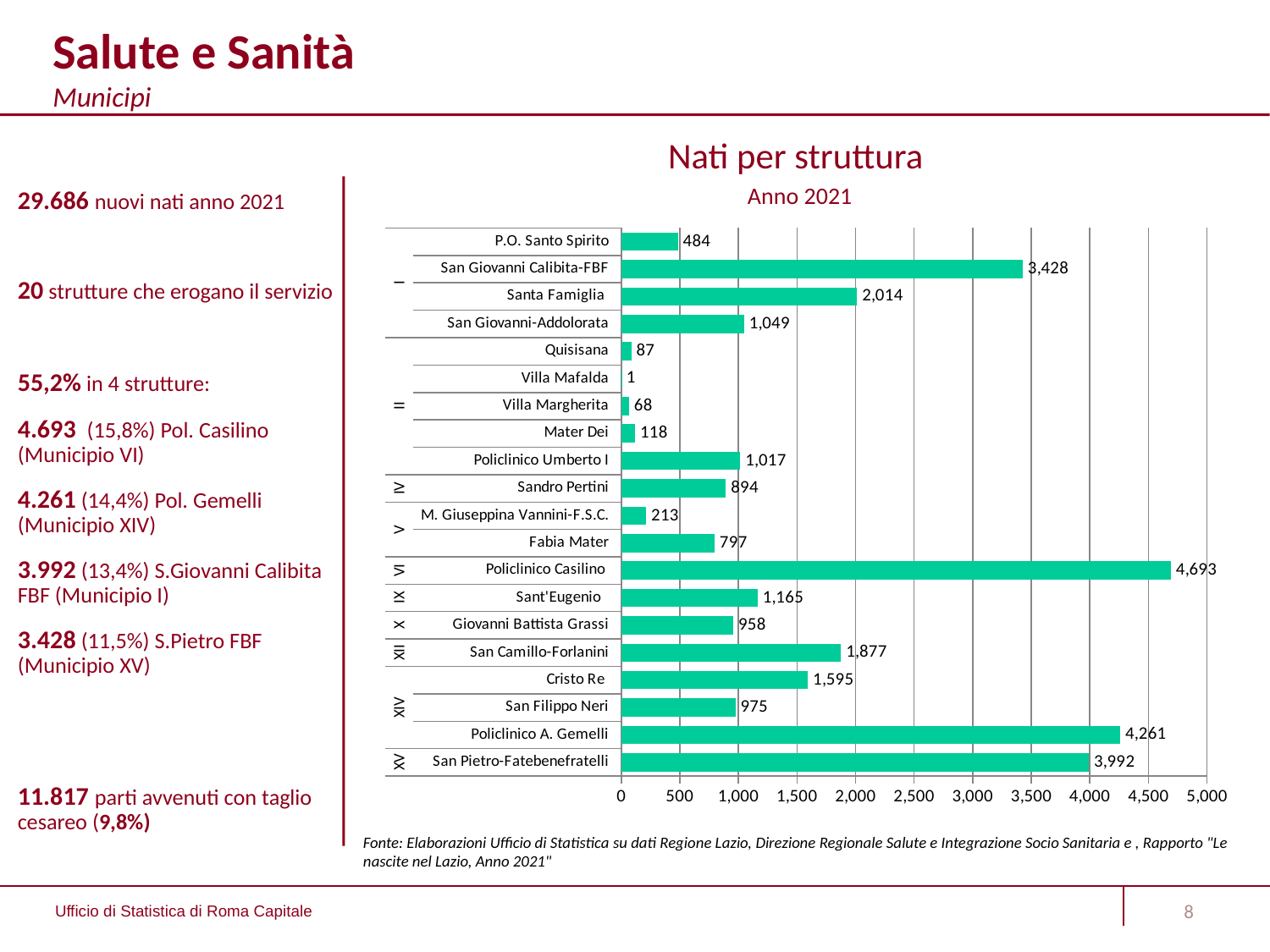
What is the value for San Camillo-Forlanini? 1,877 What year does the chart subtitle refer to? Anno 2021 Which structure has the highest number of births? Policlinico Casilino How many structures are listed in the chart? 20 Which structure has the lowest number of births? Villa Mafalda How many births are shown for Policlinico Casilino? 4,693 What is the difference between Sant'Eugenio and Giovanni Battista Grassi? 207 Which has more births, Santa Famiglia or Cristo Re? Santa Famiglia What kind of chart is shown under the title "Nati per struttura"? bar chart What is the difference between Policlinico A. Gemelli and San Pietro-Fatebenefratelli? 269 Is the value for San Giovanni Calibita-FBF greater or less than 3,000? greater What is the value for Villa Mafalda? 1